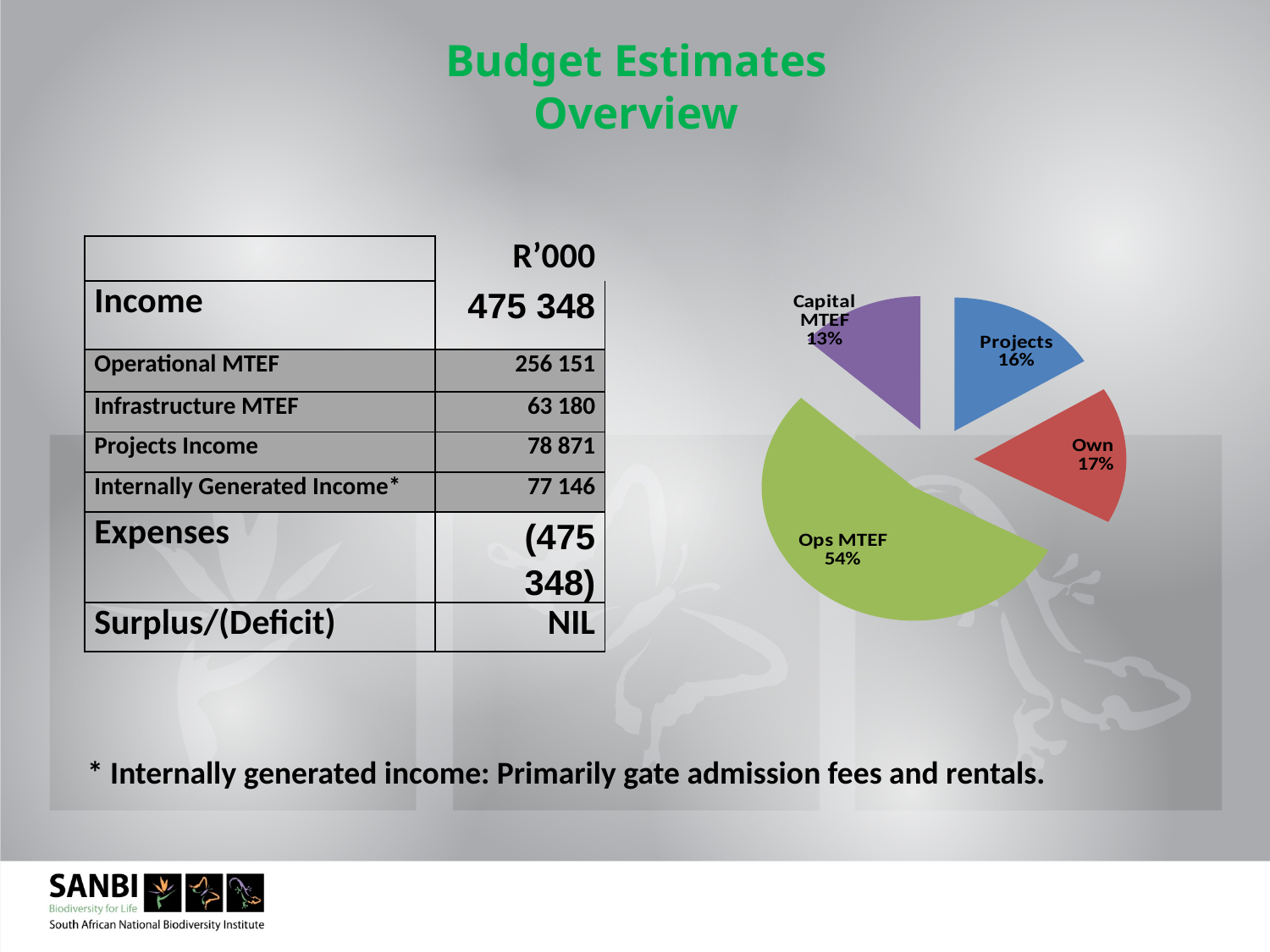
What percentage is shown for Own in the pie chart? 17% Which is larger in the pie chart, Own or Projects? Own Which slice of the pie chart is the largest? Ops MTEF What percentage is shown for Projects in the pie chart? 16% What kind of chart is shown on the slide? pie chart What percentage is shown for Capital MTEF in the pie chart? 13% How many slices does the pie chart have? 4 What is the difference in percentage points between Ops MTEF and Own? 37 What is the difference in percentage points between Projects and Capital MTEF? 3 Which slice of the pie chart is the smallest? Capital MTEF What share of the pie does Ops MTEF represent? 54% What colour is the Ops MTEF slice in the pie chart? green